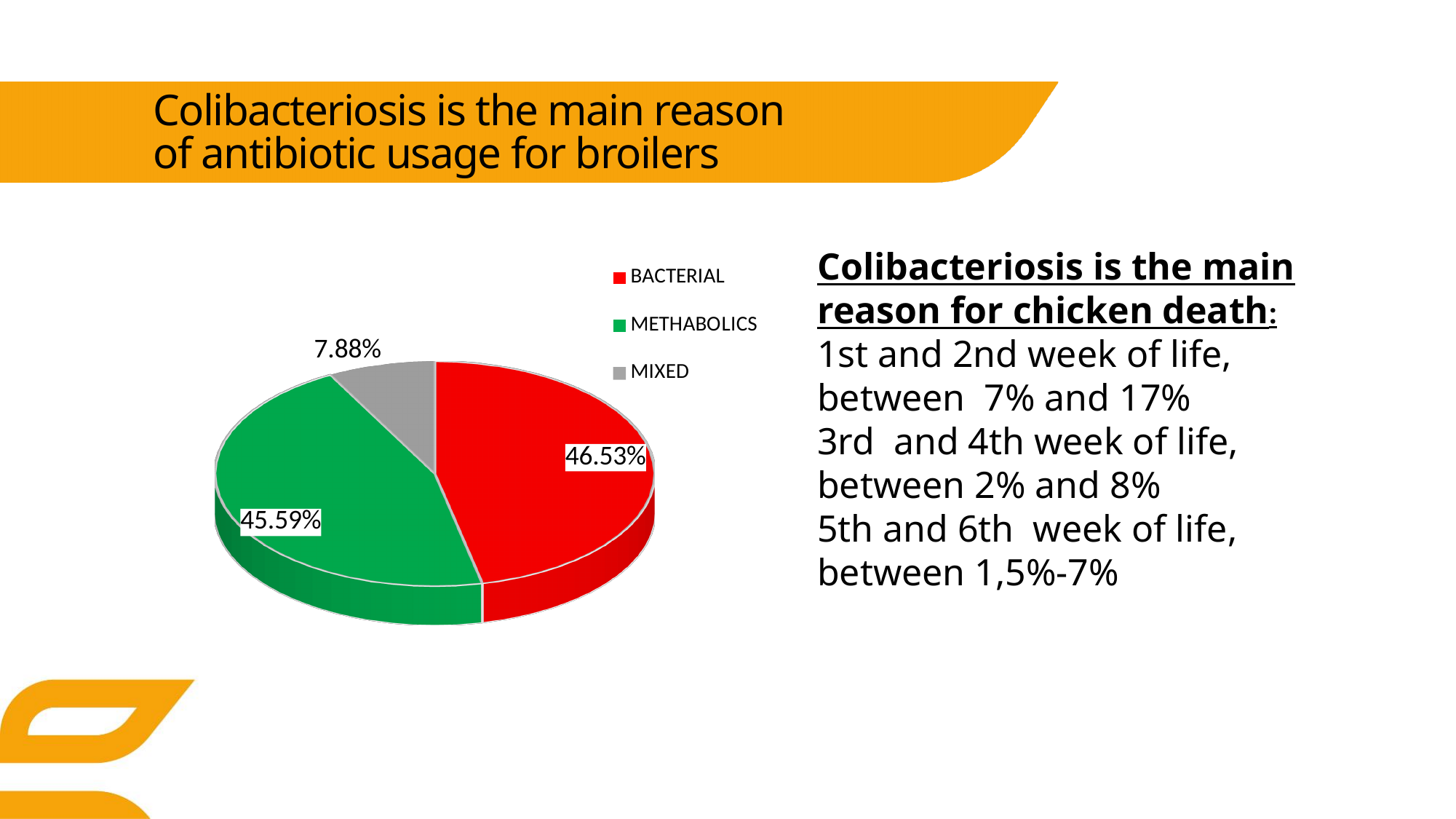
Which category has the smallest slice in the pie chart? MIXED What percentage of the pie chart does the MIXED slice represent? 7.88% What percentage of the pie chart does the METHABOLICS slice represent? 45.59% How many slices does the pie chart have? 3 What is the difference between the BACTERIAL and METHABOLICS percentages in the pie chart? 0.94% How many entries does the legend of the pie chart list? 3 Which category has the largest slice in the pie chart? BACTERIAL What kind of chart is shown on the slide? Pie chart What is the difference between the BACTERIAL and MIXED percentages in the pie chart? 38.65% Which is larger in the pie chart, the METHABOLICS slice or the MIXED slice? METHABOLICS What colour is the MIXED slice in the pie chart? Grey What percentage of the pie chart does the BACTERIAL slice represent? 46.53%